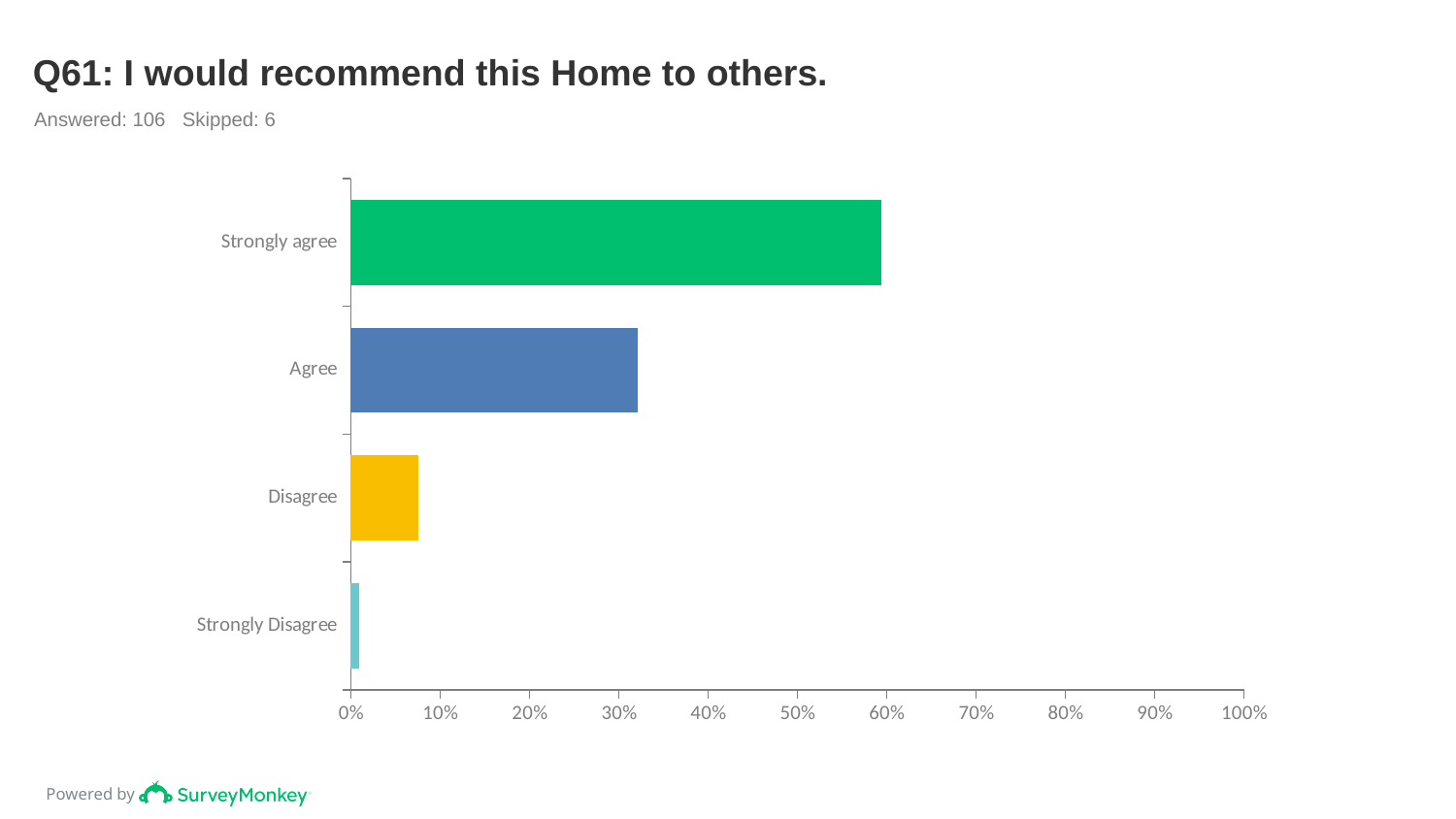
Is the value for Disagree greater or less than 10%? less Which category has the lowest value? Strongly Disagree What colour is the bar for Disagree? yellow Which is larger, the value for Agree or the value for Disagree? Agree How many categories are plotted on the chart? 4 Is the value for Agree greater or less than 40%? less What is the title of the chart? Q61: I would recommend this Home to others. Which category has the highest value? Strongly agree What kind of chart is shown on the slide? bar chart Which is larger, the value for Strongly agree or the value for Agree? Strongly agree Is the value for Strongly agree greater or less than 50%? greater